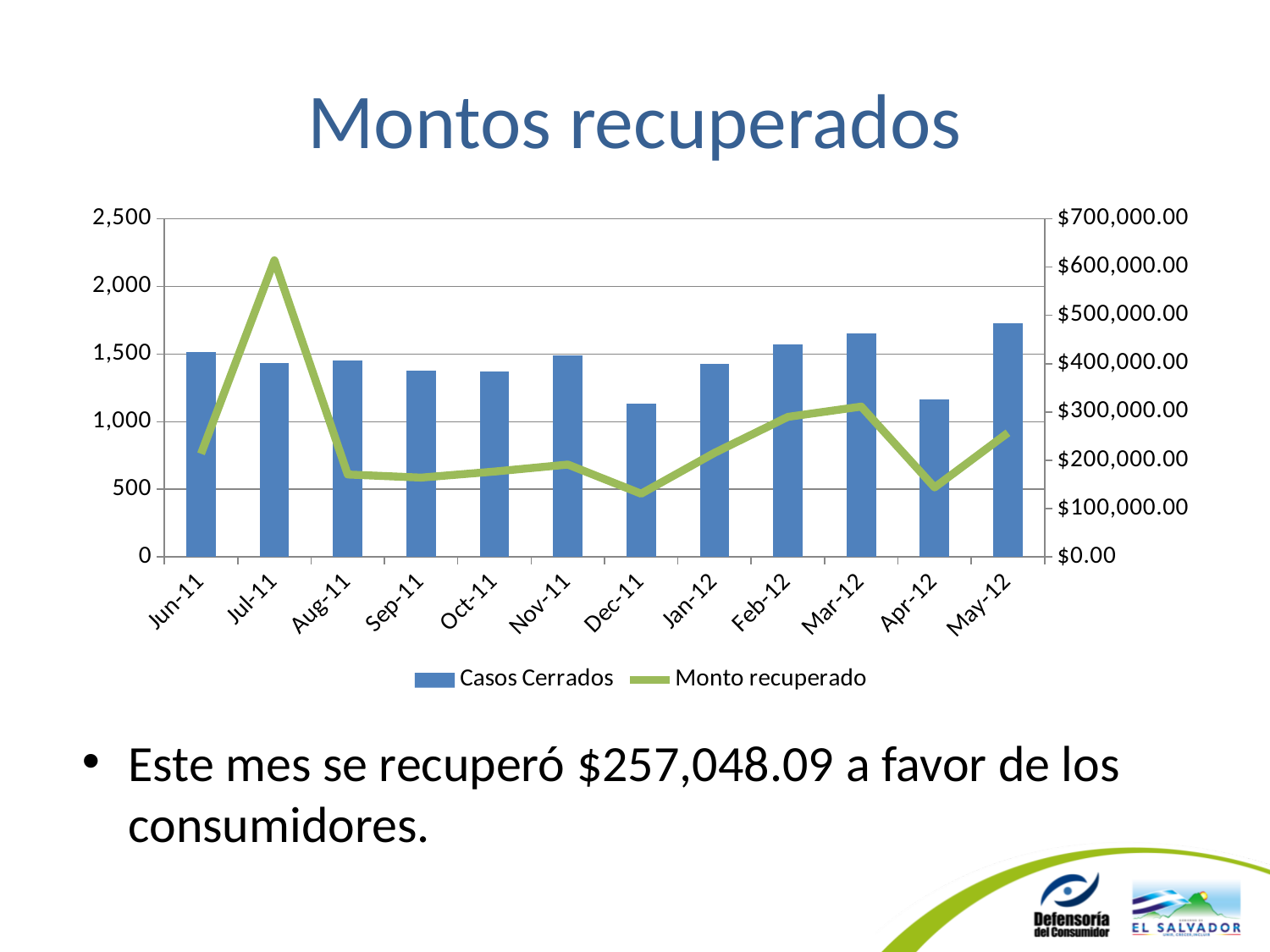
Which month has a larger Casos Cerrados value, Feb-12 or Dec-11? Feb-12 Is the value of Monto recuperado for Dec-11 greater or less than $200,000.00? less How many series does the chart legend list? 2 What kind of chart is shown on the slide? A combination bar and line chart In which month is Monto recuperado highest? Jul-11 Is the value of Monto recuperado for Jul-11 greater or less than $500,000.00? greater What are the two series named in the chart legend? Casos Cerrados and Monto recuperado Is the value of Casos Cerrados for May-12 greater or less than 1,500? greater What is the title of the chart? Montos recuperados In which month is Casos Cerrados highest? May-12 How many months are shown on the x axis of the chart? 12